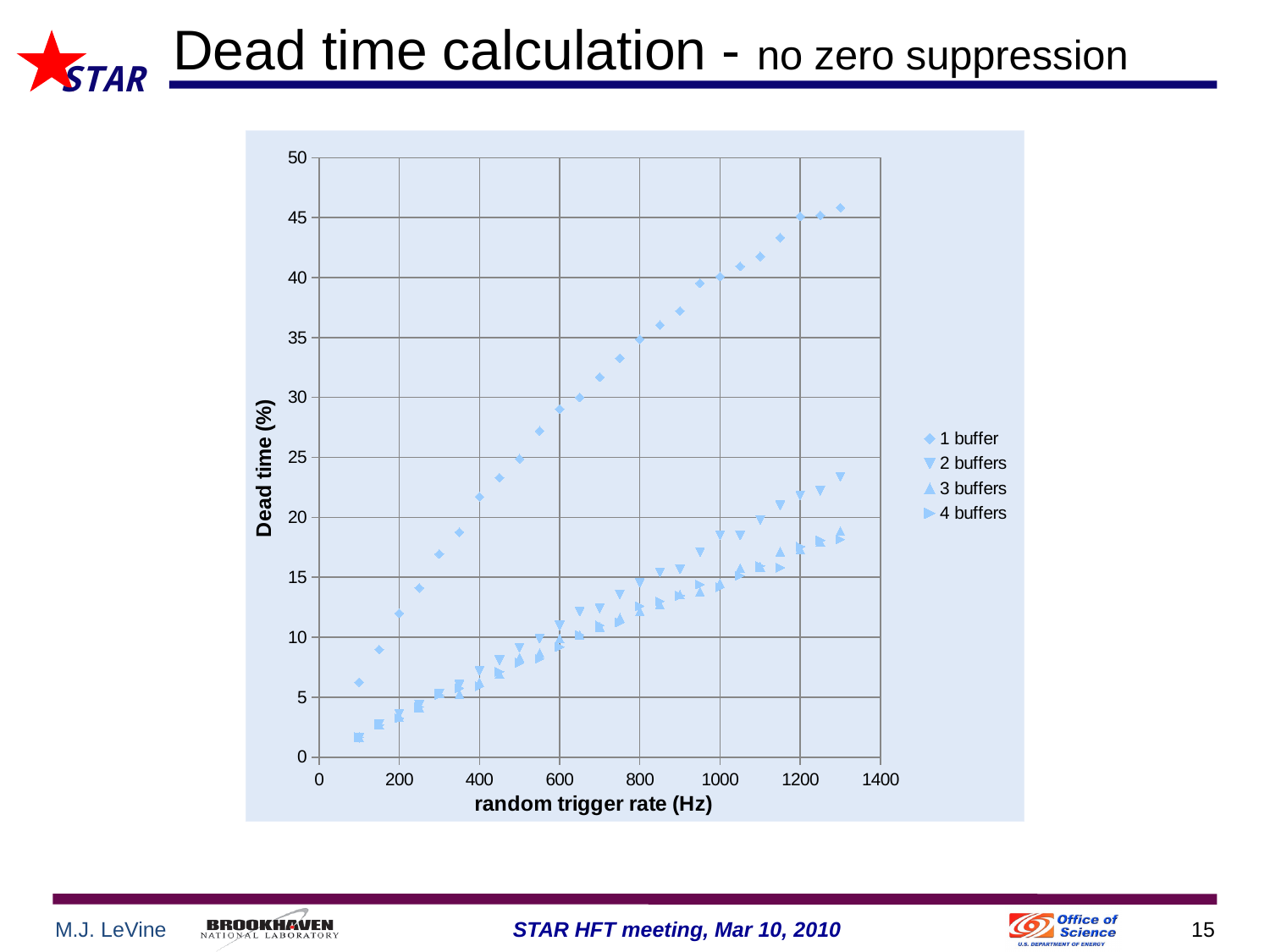
What is the title of the x axis? random trigger rate (Hz) Is the dead time for 4 buffers at 1300 Hz greater or less than 20? less Is the dead time for 2 buffers at 1300 Hz greater or less than 20? greater Which series has the highest dead time at 1200 Hz? 1 buffer How many series does the legend list? 4 What kind of chart is shown on the slide? scatter chart Is the dead time for 1 buffer at 100 Hz greater or less than 10? less What is the title of the y axis? Dead time (%) Does the dead time for the 1 buffer series rise or fall as the random trigger rate increases? rise At 1000 Hz, which series has the larger dead time, 1 buffer or 2 buffers? 1 buffer